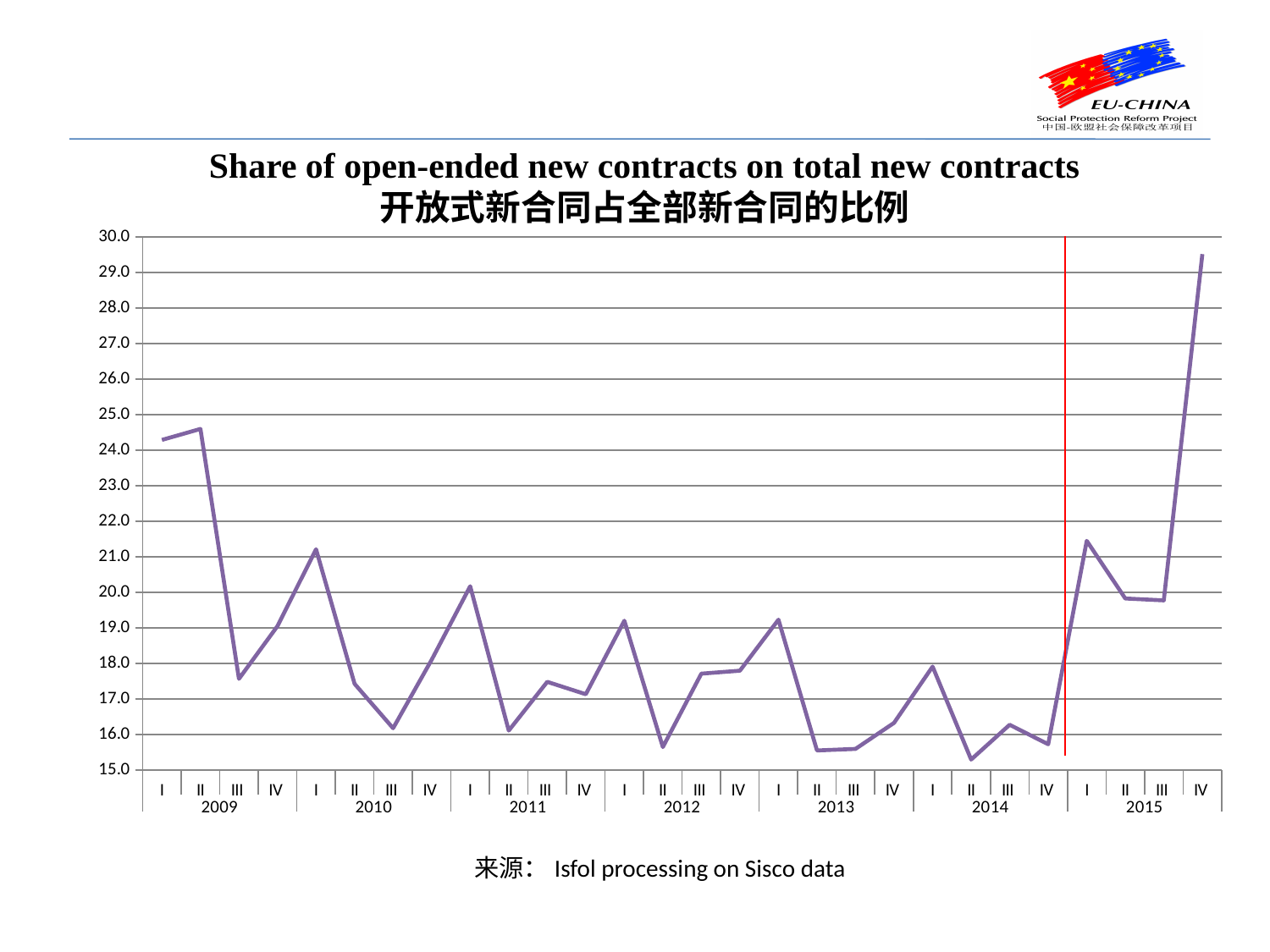
What is the English title of the chart? Share of open-ended new contracts on total new contracts Is the value for 2009 I greater or less than 24.0? greater Does the line rise or fall from 2015 III to 2015 IV? rise How many quarterly data points are plotted on the chart? 28 Which is larger, the value for 2009 II or the value for 2009 III? 2009 II Which quarter has the highest share of open-ended new contracts? 2015 IV Is the value for 2014 II greater or less than 16.0? less How many years are labelled along the x axis? 7 Is the value for 2015 IV greater or less than 29.0? greater What kind of chart is shown on the slide? line chart